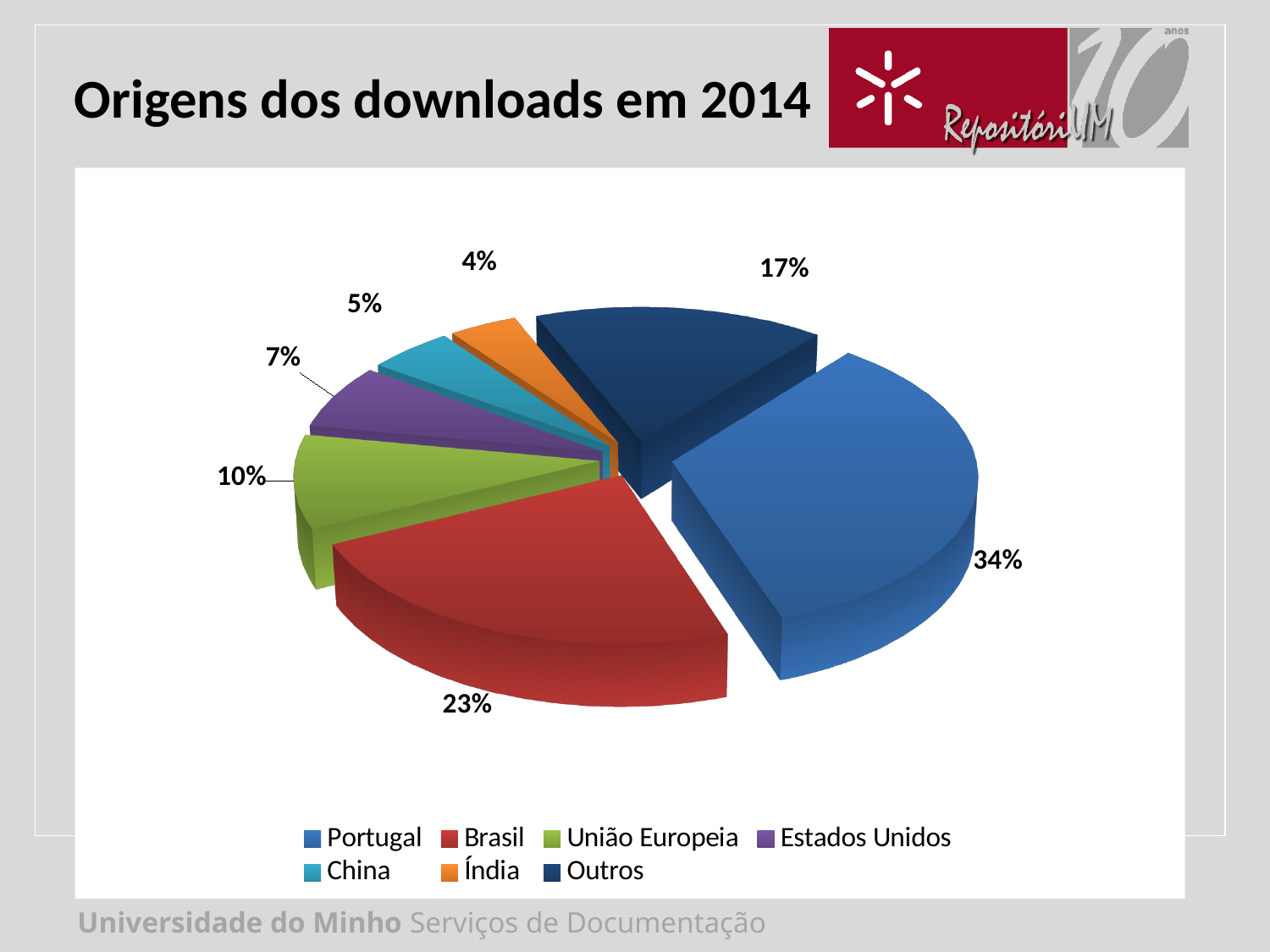
What percentage is shown for União Europeia? 10% What share of downloads in 2014 came from Brasil? 23% Which origin has the largest share of downloads? Portugal What percentage is shown for Índia? 4% How many categories does the legend list? 7 How many percentage points larger is Portugal's share than Brasil's? 11 What kind of chart is shown on the slide? pie chart What percentage is shown for Outros? 17% What share of downloads in 2014 came from Portugal? 34% What percentage is shown for Estados Unidos? 7% What percentage is shown for China? 5% Which origin has the smallest share of downloads? Índia